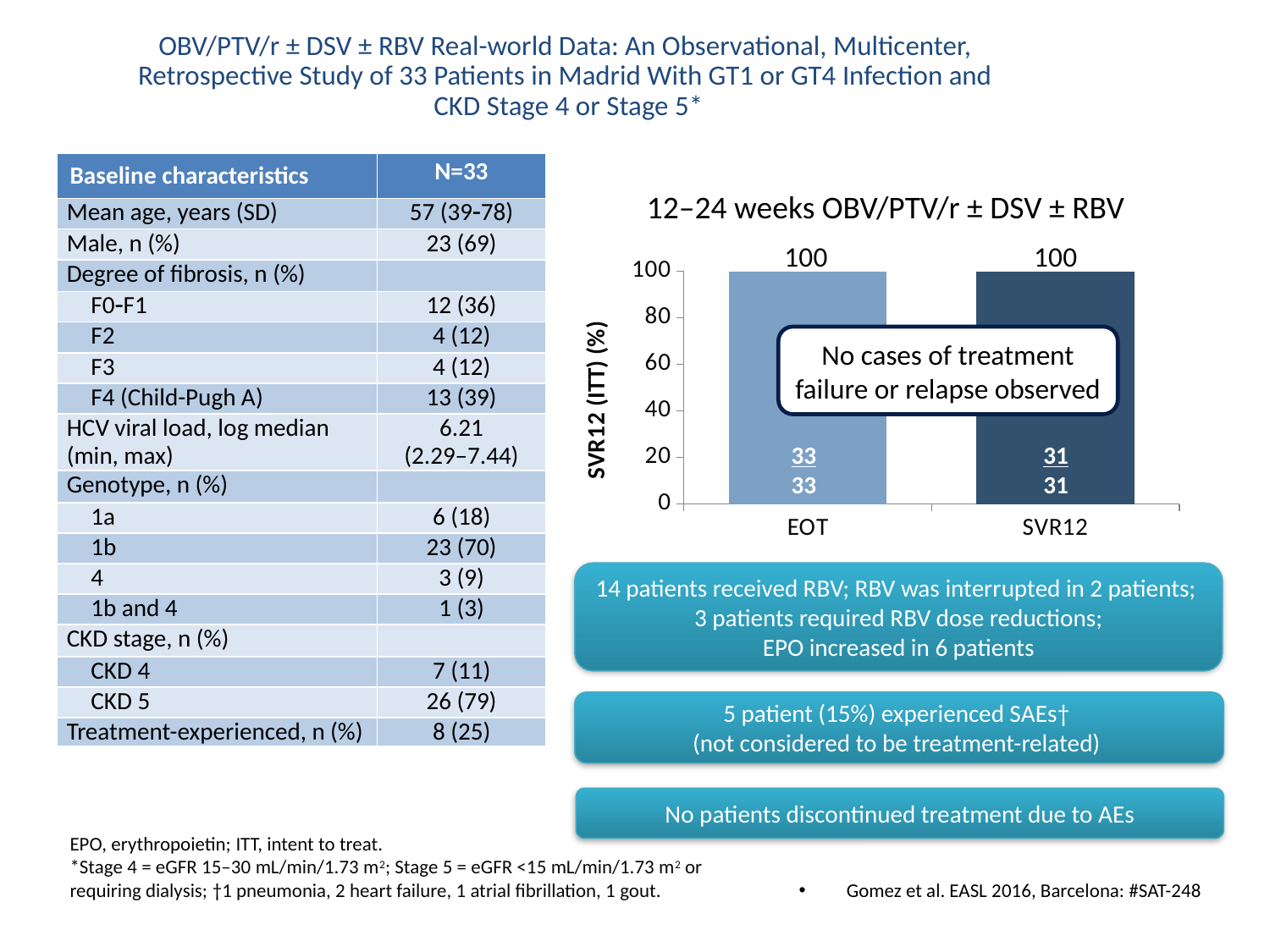
Is the value for EOT greater or less than 60? greater Do the values rise, fall or stay the same from EOT to SVR12 in the bar chart? stay the same How many categories are shown on the x axis of the bar chart? 2 What is the label on the y axis of the bar chart? SVR12 (ITT) (%) What is the difference between the EOT and SVR12 values in the bar chart? 0 What is the value for EOT in the bar chart? 100 Is the value for SVR12 greater or less than 80? greater What is the title of the bar chart? 12–24 weeks OBV/PTV/r ± DSV ± RBV What is the value for SVR12 in the bar chart? 100 What fraction of patients is printed inside the SVR12 bar? 31/31 What kind of chart is shown on the slide? bar chart What fraction of patients is printed inside the EOT bar? 33/33